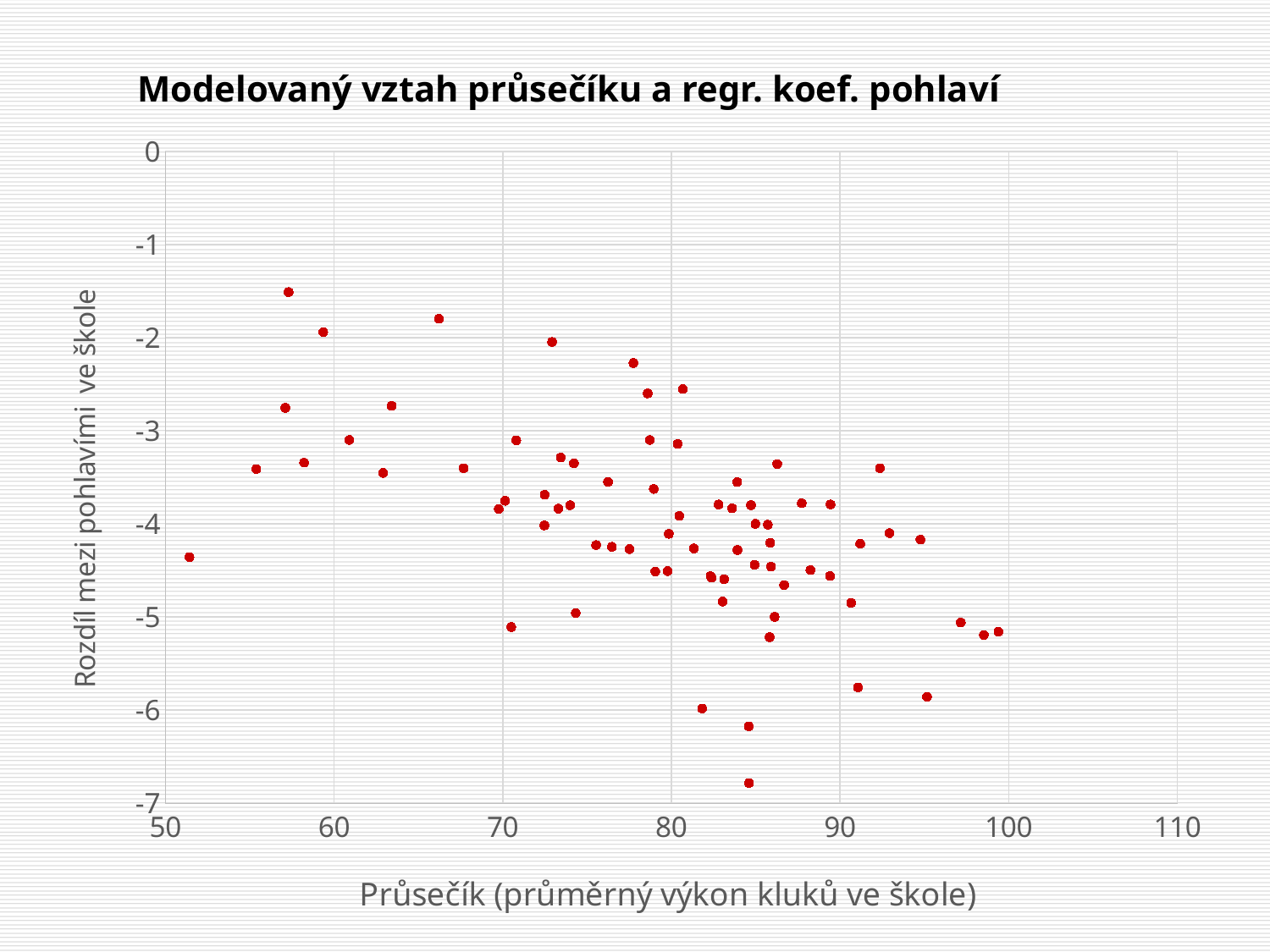
What is the label of the x axis? Průsečík (průměrný výkon kluků ve škole) Is the y value of the highest point (near x = 57) greater or less than -2? greater Is the x value of the lowest point on the chart greater or less than 80? greater Is the y value of the lowest point on the chart greater or less than -6? less As the x-axis value (Průsečík) increases, do the y values generally rise or fall? fall What is the title of the chart? Modelovaný vztah průsečíku a regr. koef. pohlaví What kind of chart is shown on the slide? scatter chart